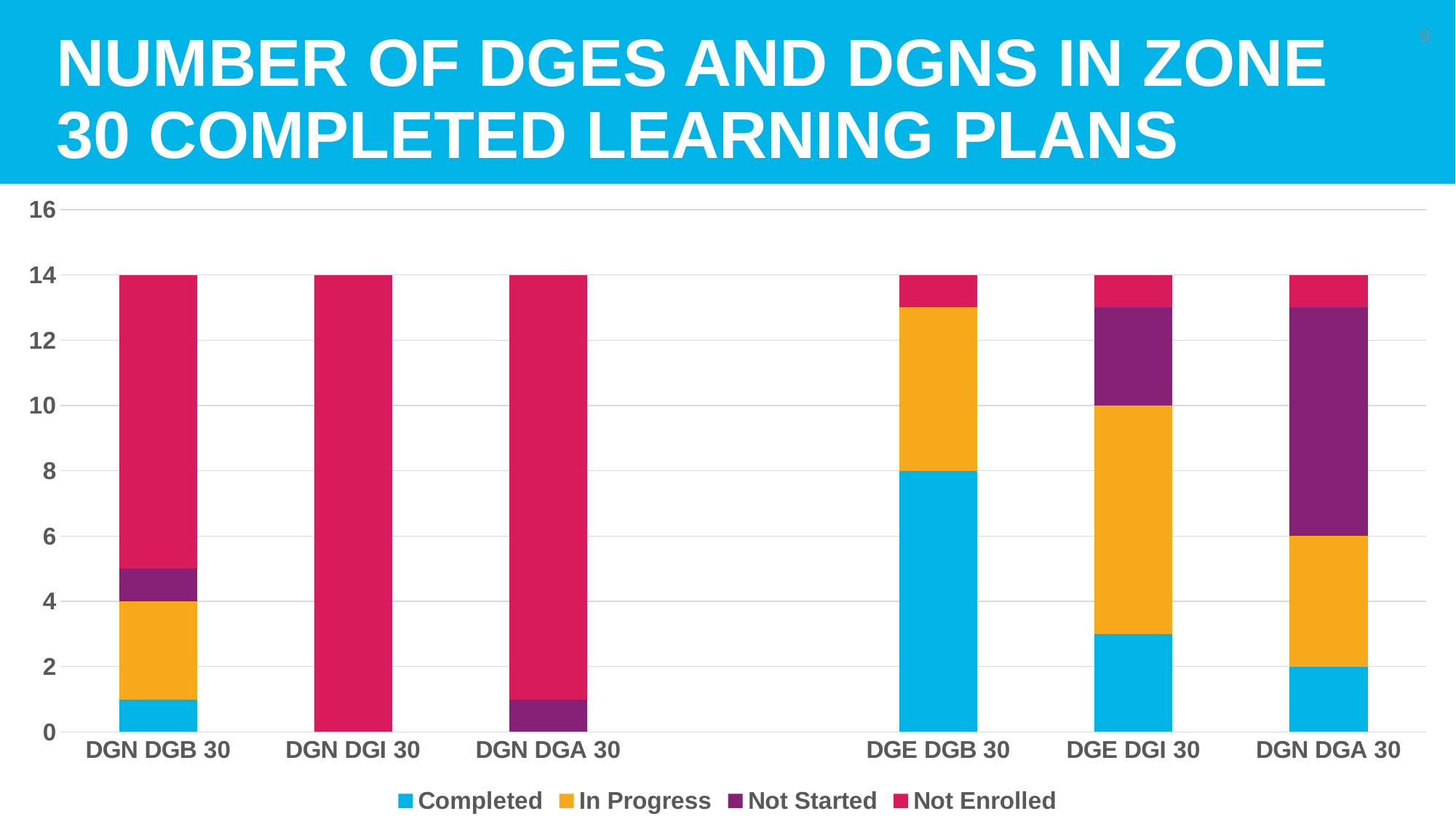
What is the Completed value for the rightmost category, DGN DGA 30? 2 What is the Not Enrolled value for DGN DGI 30? 14 Which series is shown in blue in the legend? Completed Which category has the largest Completed segment? DGE DGB 30 How many labeled categories are shown on the x axis? 6 Which is larger, the Completed value for DGE DGB 30 or for DGE DGI 30? DGE DGB 30 Is the Completed value for DGE DGI 30 greater or less than 4? less Is the total for DGE DGB 30 greater or less than 16? less What is the Completed value for DGE DGB 30? 8 How many series does the legend list? 4 What kind of chart is shown on the slide? Stacked bar chart What is the total height of the stacked bar for DGN DGI 30? 14